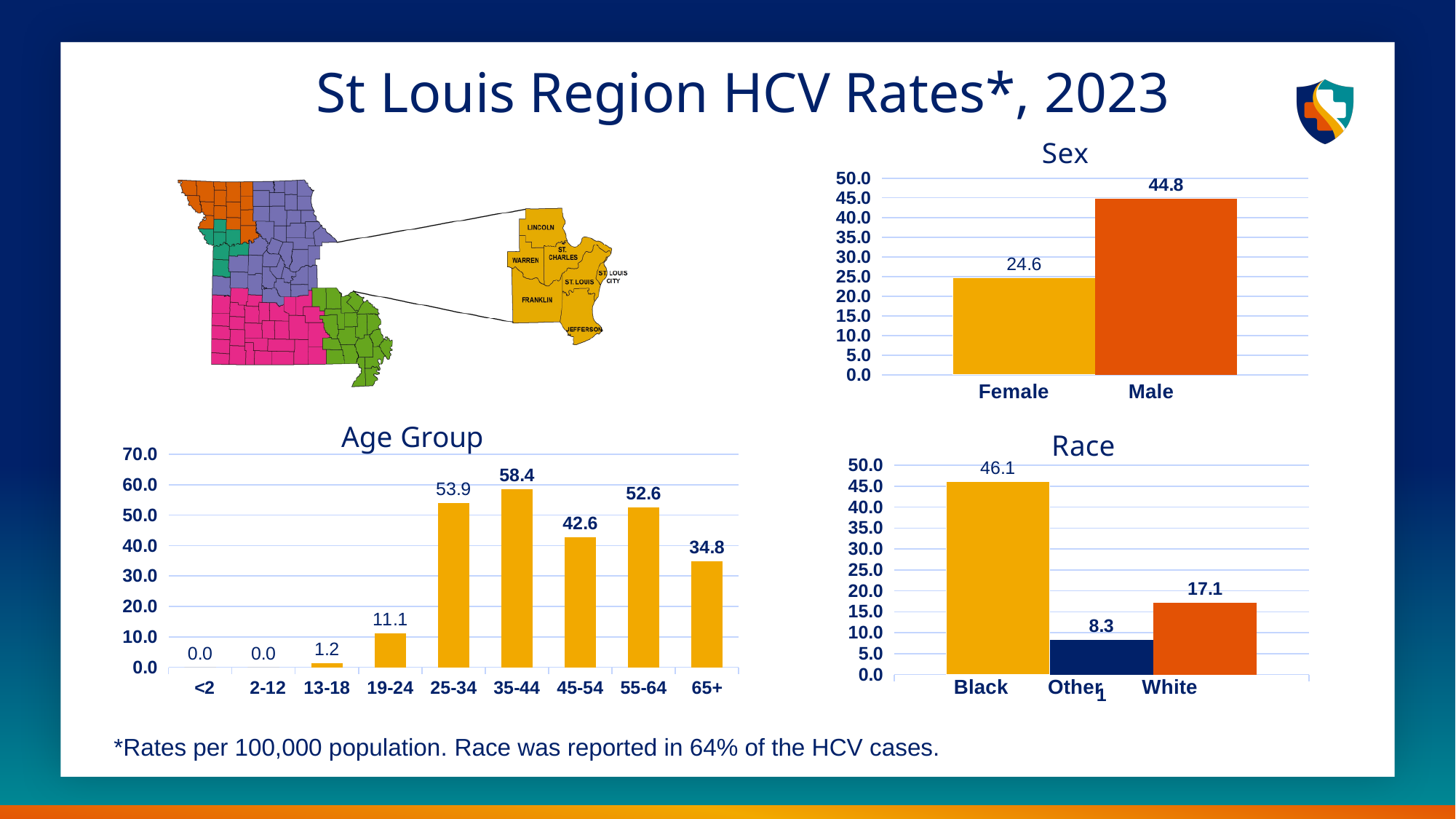
In the Age Group chart, which is larger, the value for 25-34 or the value for 55-64? 25-34 In the Race chart, what is the value for Black? 46.1 In the Sex chart, what is the value for Male? 44.8 In the Age Group chart, what is the value for the 19-24 age group? 11.1 What kind of chart is the Age Group chart? Bar chart In the Age Group chart, what is the value for the 65+ age group? 34.8 In the Sex chart, what is the value for Female? 24.6 In the Age Group chart, which age group has the highest value? 35-44 In the Age Group chart, how many age group categories are shown? 9 In the Race chart, which category has the lowest value? Other In the Sex chart, what is the difference between the Male and Female values? 20.2 In the Race chart, what is the difference between the Black and White values? 29.0